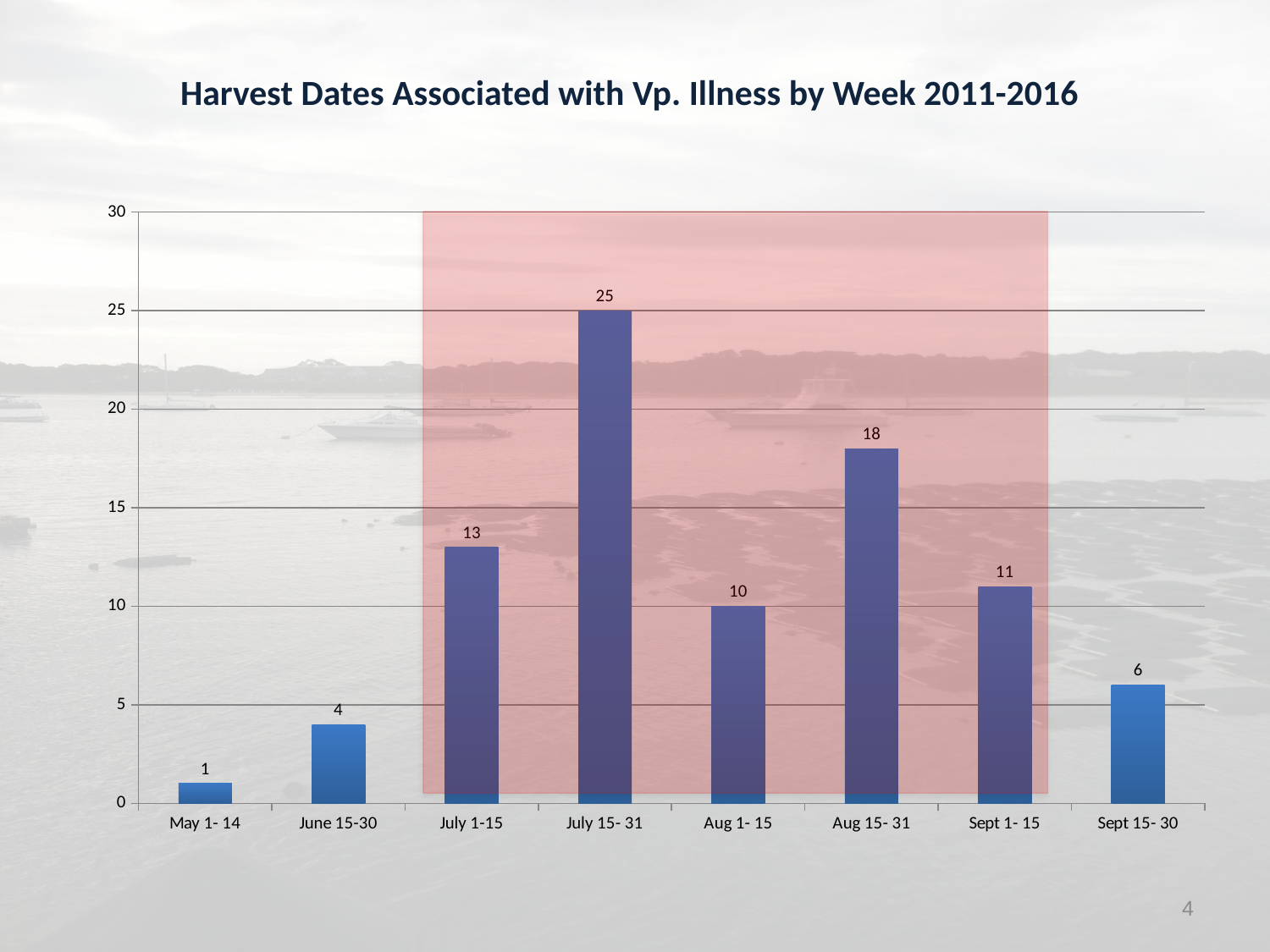
What is the difference between the values for July 15- 31 and Aug 1- 15? 15 Which is larger, the value for July 1-15 or the value for Sept 1- 15? July 1-15 What kind of chart is shown on the slide? bar chart What is the difference between the values for June 15-30 and May 1- 14? 3 What is the value for Aug 15- 31? 18 Which period has the lowest value? May 1- 14 What is the title of the chart? Harvest Dates Associated with Vp. Illness by Week 2011-2016 What is the value for July 15- 31? 25 What is the value for Sept 15- 30? 6 Is the value for Aug 15- 31 greater or less than 15? greater Which period has the highest value? July 15- 31 How many periods are shown on the x axis? 8